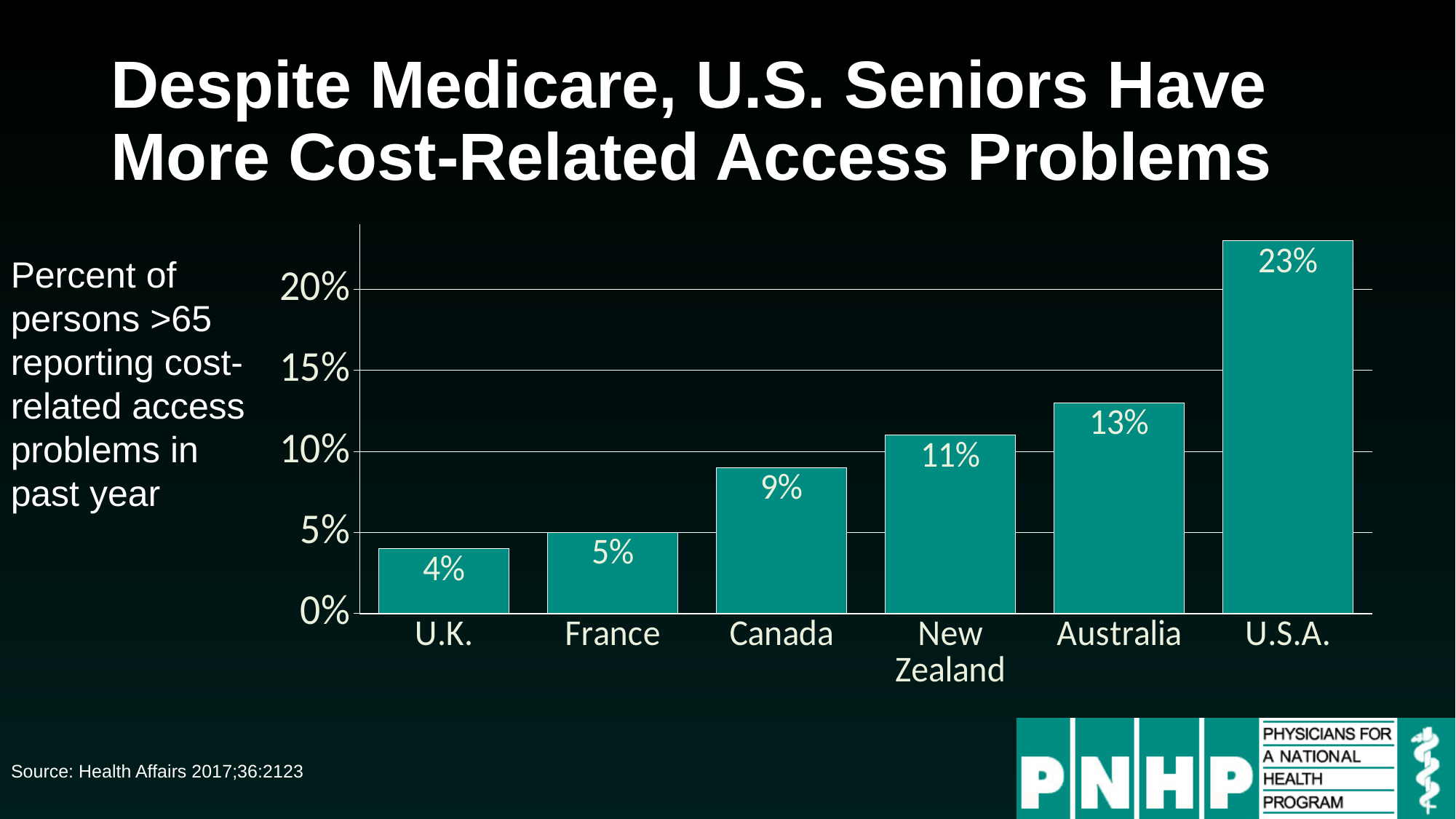
What is the value for the U.S.A.? 23% Is the value for the U.S.A. greater or less than 20%? greater How many countries are shown in the chart? 6 Do the values rise or fall from left to right across the countries? Rise What is the value for Canada? 9% Which is larger, the value for Australia or the value for Canada? Australia What is the difference between the values for the U.S.A. and Australia? 10% Which country has the lowest value? U.K. What kind of chart is shown on the slide? Bar chart Which country has the highest value? U.S.A. What is the difference between the values for France and the U.K.? 1% What is the value for New Zealand? 11%